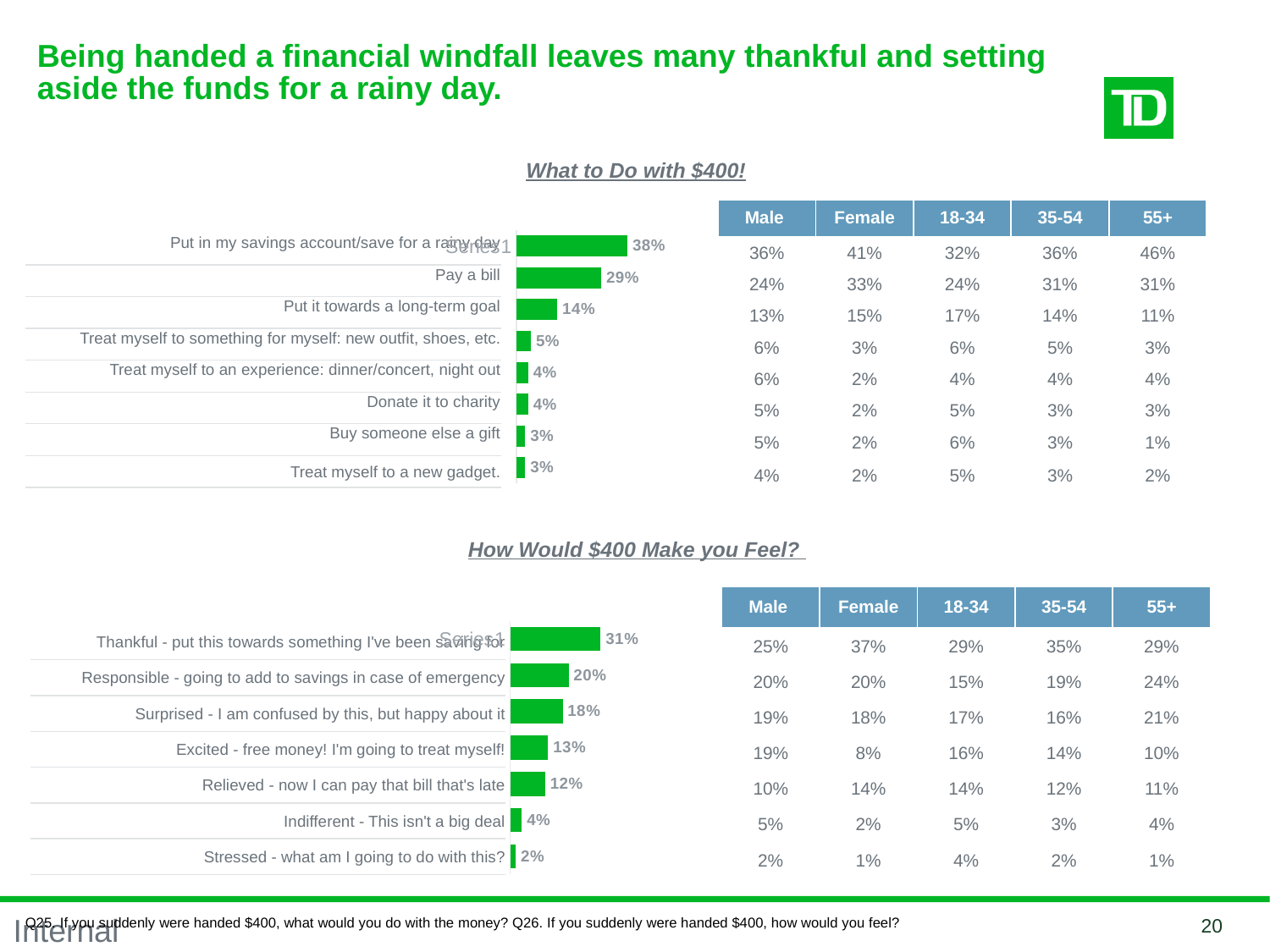
In the 'What to Do with $400!' chart, what is the difference between 'Put in my savings account/save for a rainy day' and 'Pay a bill'? 9% In the 'How Would $400 Make you Feel?' chart, how many categories are plotted? 7 In the 'How Would $400 Make you Feel?' chart, which category has the lowest value? Stressed - what am I going to do with this? In the 'What to Do with $400!' chart, which category has the highest value? Put in my savings account/save for a rainy day What colour are the bars in the 'How Would $400 Make you Feel?' chart? Green In the 'How Would $400 Make you Feel?' chart, what is the difference between 'Thankful - put this towards something I've been saving for' and 'Relieved - now I can pay that bill that's late'? 19% In the 'How Would $400 Make you Feel?' chart, which is larger: 'Responsible - going to add to savings in case of emergency' or 'Surprised - I am confused by this, but happy about it'? Responsible - going to add to savings in case of emergency What type of chart is the 'What to Do with $400!' chart? Bar chart In the 'What to Do with $400!' chart, what is the value for 'Pay a bill'? 29% In the 'How Would $400 Make you Feel?' chart, what is the value for 'Excited - free money! I'm going to treat myself!'? 13% In the 'What to Do with $400!' chart, what is the value for 'Put it towards a long-term goal'? 14% In the 'What to Do with $400!' chart, how many categories are plotted? 8